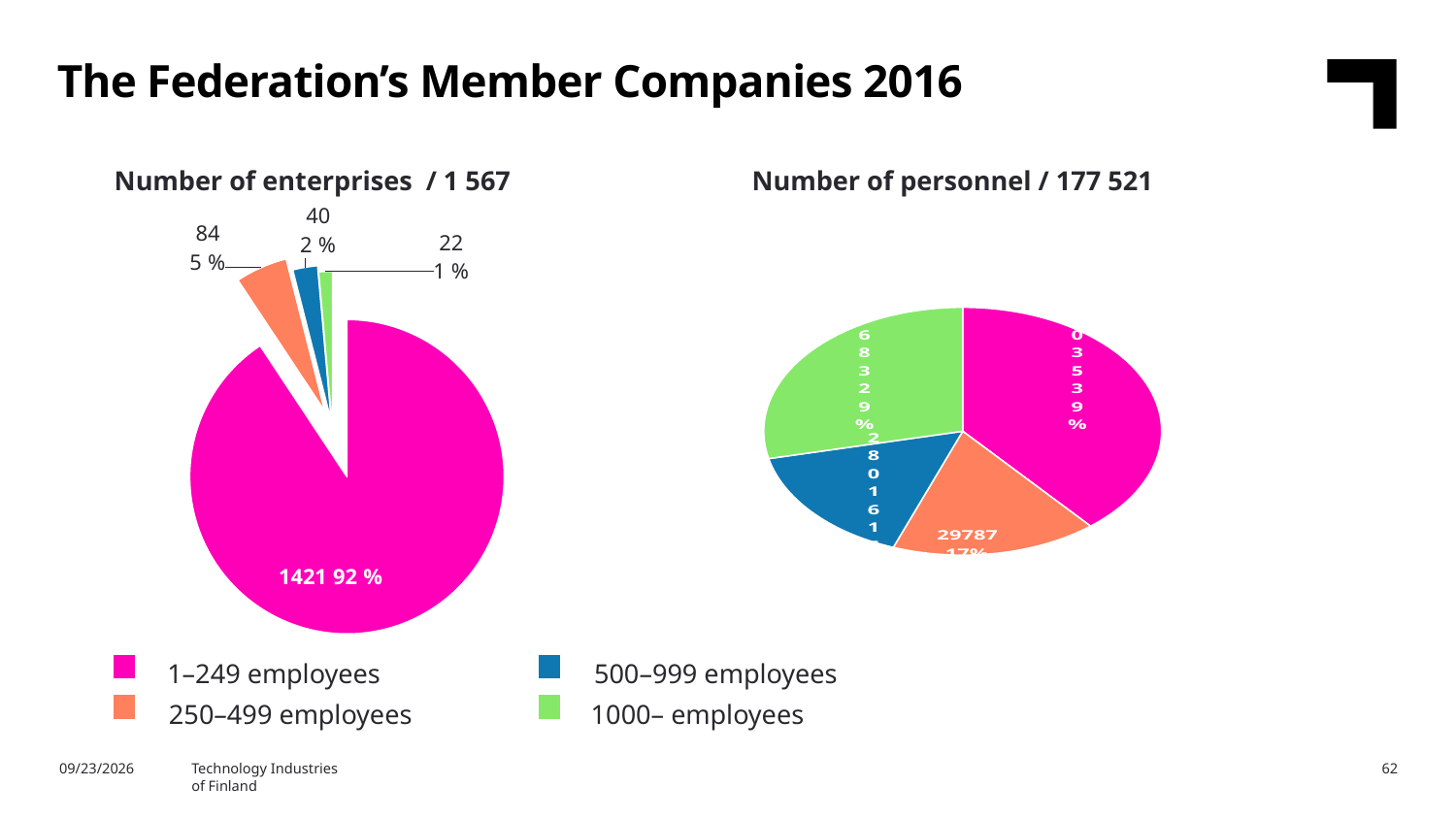
In the 'Number of personnel / 177 521' chart, how many personnel are in the 250–499 employees category? 29787 What kind of chart is the 'Number of enterprises / 1 567' chart? pie chart In the 'Number of enterprises / 1 567' chart, which size category has the smallest slice? 1000– employees In the 'Number of enterprises / 1 567' chart, what share of enterprises have 1–249 employees? 92 % In the 'Number of enterprises / 1 567' chart, how many enterprises have 1000 or more employees? 22 In the 'Number of enterprises / 1 567' chart, how many enterprises have 1–249 employees? 1421 In the 'Number of enterprises / 1 567' chart, how many enterprises have 500–999 employees? 40 In the 'Number of enterprises / 1 567' chart, how many more enterprises have 250–499 employees than 1000 or more employees? 62 In the 'Number of enterprises / 1 567' chart, how many enterprises have 250–499 employees? 84 In the 'Number of enterprises / 1 567' chart, what share of enterprises have 250–499 employees? 5 % In the 'Number of personnel / 177 521' chart, which size category has the largest slice? 1–249 employees How many employee-size categories does the legend list? 4